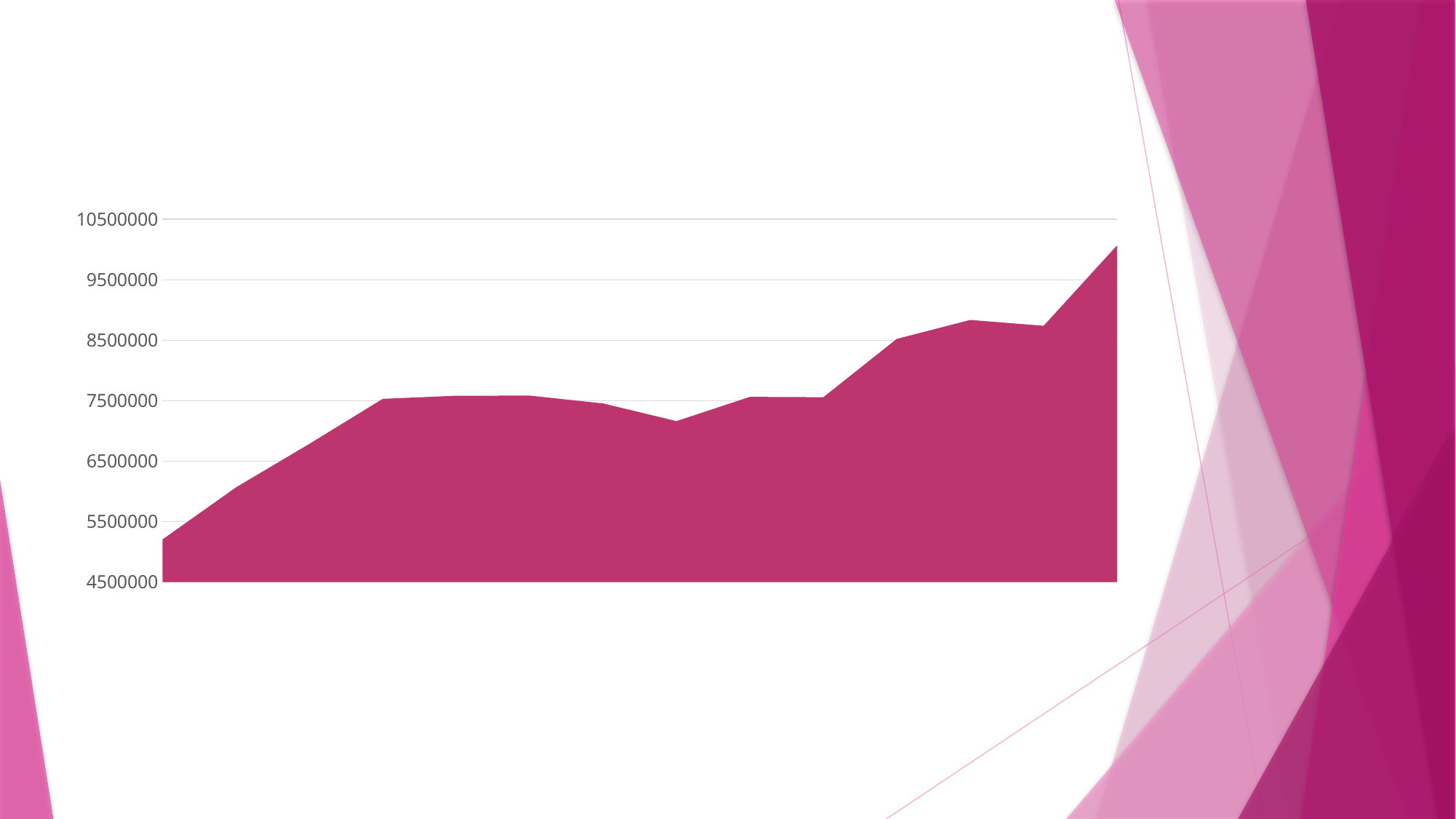
Is the value at the first (leftmost) point greater or less than 5500000? less What is the highest value shown on the vertical axis? 10500000 Do the values generally rise or fall from left to right along the x axis? rise Where along the x axis does the lowest value occur? at the first (leftmost) point What is the lowest value shown on the vertical axis? 4500000 What kind of chart is shown on the slide? area chart Is the value at the lowest dip in the middle of the chart greater or less than 6500000? greater Is the value at the last (rightmost) point greater or less than 9500000? greater Which point has the highest value, the first point or the last point? the last point Where along the x axis does the highest value occur? at the last (rightmost) point